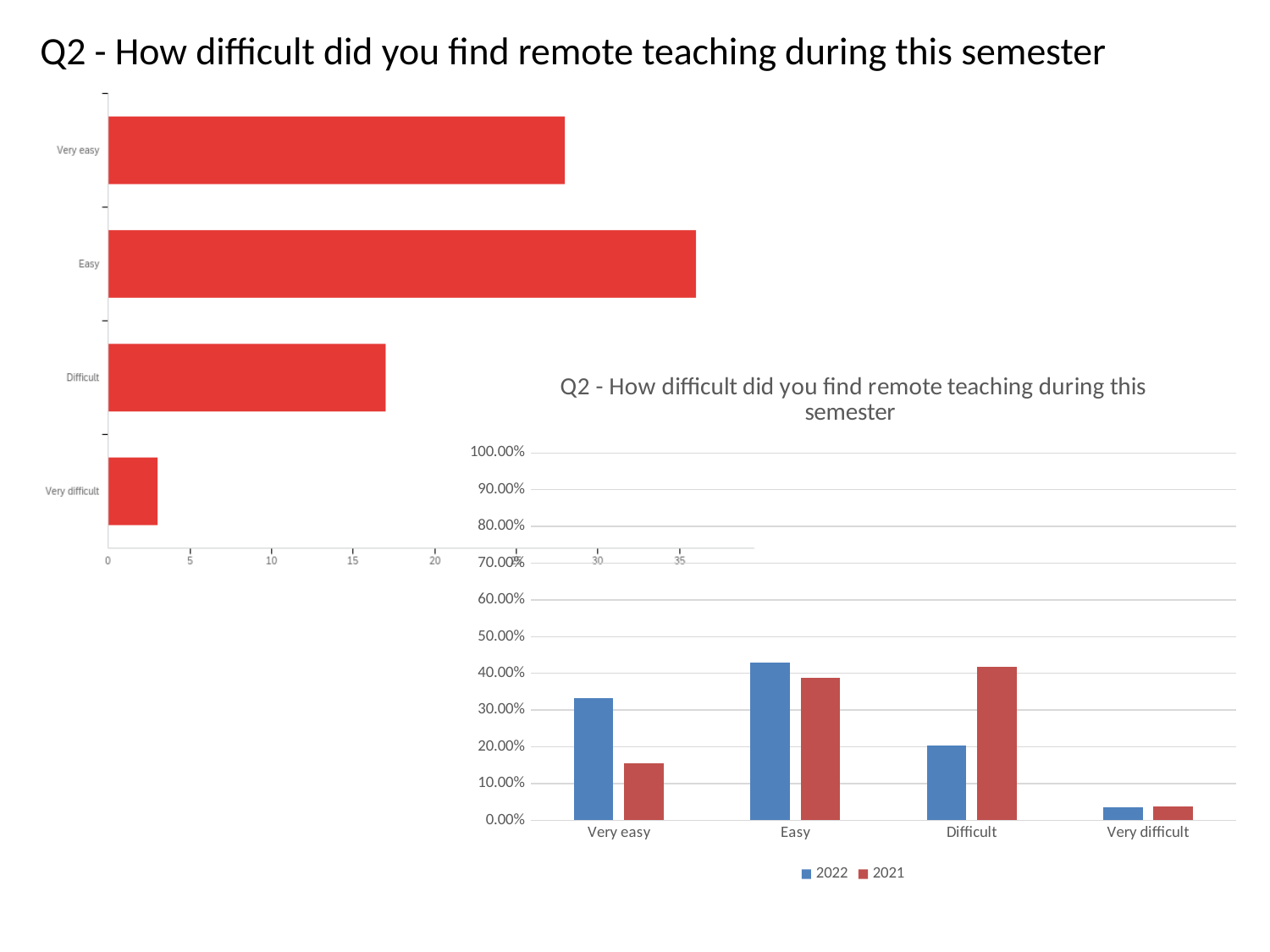
In the chart on the right side of the slide, is the 2021 value for Difficult greater or less than 30.00%? greater How many categories does the chart on the left side of the slide show? 4 In the chart on the left side of the slide, is the value for Difficult greater or less than 20? less What kind of chart is the chart on the left side of the slide? bar chart In the chart on the right side of the slide, which colour represents the 2021 series? red In the chart on the left side of the slide, is the value for Easy greater or less than 35? greater In the chart on the right side of the slide, for the Very easy category, which series has the larger value, 2022 or 2021? 2022 In the chart on the left side of the slide, which category has the longest bar? Easy How many series does the legend list in the chart titled 'Q2 - How difficult did you find remote teaching during this semester' on the right? 2 In the chart on the right side of the slide, which category has the highest value for the 2021 series? Difficult In the chart on the left side of the slide, which category has the shortest bar? Very difficult In the chart on the right side of the slide, which category has the highest value for the 2022 series? Easy